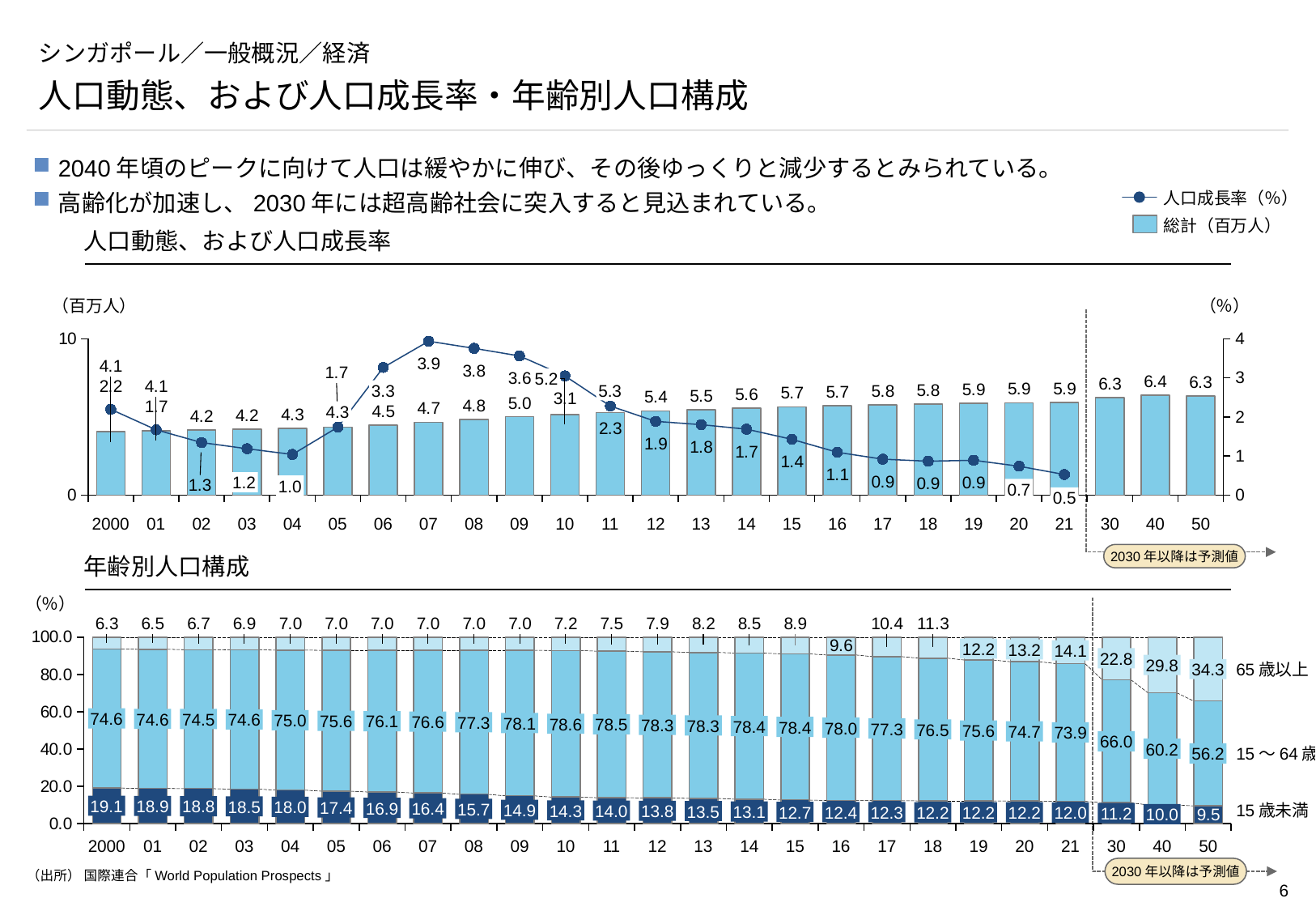
In the bottom chart (年齢別人口構成), what is the share of the 65歳以上 group in 2050? 34.3 In the top chart (人口動態、および人口成長率), does the population growth rate rise or fall from 2011 to 2021? fall In the bottom chart (年齢別人口構成), which is larger in 2021: the 65歳以上 share or the 15歳未満 share? 65歳以上 (14.1) In the bottom chart (年齢別人口構成), how many age groups are stacked in each bar? 3 In the top chart (人口動態、および人口成長率), what is the difference between the total population in 2021 and in 2000? 1.8 In the top chart (人口動態、および人口成長率), what is the lowest population growth rate (人口成長率) value shown, and in which year? 0.5 in 2021 In the top chart (人口動態、および人口成長率), which year has the highest total population (総計) value? 2040 In the top chart (人口動態、および人口成長率), what is the total population (総計) shown for 2021? 5.9 In the bottom chart (年齢別人口構成), what is the share of the 15歳未満 group in 2000? 19.1 What kind of chart is the bottom chart (年齢別人口構成)? stacked bar chart In the top chart (人口動態、および人口成長率), how many series does the legend list? 2 In the top chart (人口動態、および人口成長率), what is the population growth rate (人口成長率) shown for 2007? 3.9